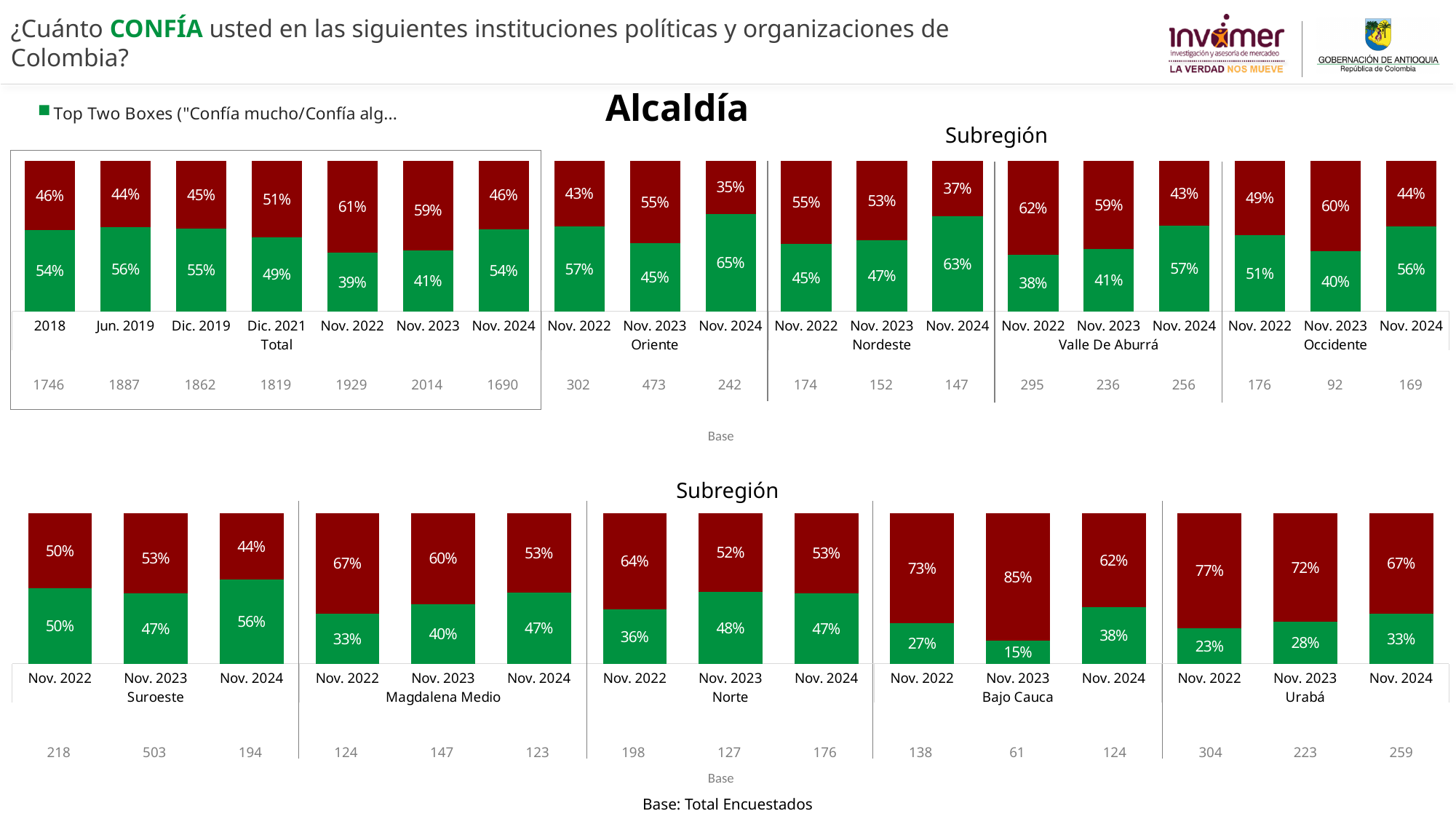
In the top chart, by how many percentage points did the green (Top Two Boxes) value for Total change from Nov. 2023 to Nov. 2024? 13 percentage points In the top chart, what is the base (number of respondents) for Total in Nov. 2024? 1690 In the bottom chart, which bar has the lowest green (Top Two Boxes) value? Bajo Cauca Nov. 2023 In the top chart, how many bars are shown in the Total group? 7 In the top chart, which subregion bar has the highest green (Top Two Boxes) value? Oriente Nov. 2024 In the bottom chart, what is the green (Top Two Boxes) value for Bajo Cauca in Nov. 2023? 15% In the top chart, what is the green (Top Two Boxes) value for Total in Nov. 2022? 39% In the bottom chart, do the green (Top Two Boxes) values for Urabá rise or fall from Nov. 2022 to Nov. 2024? Rise In the top chart, what is the green (Top Two Boxes) value for Total in Nov. 2024? 54% What kind of chart is used on this slide? Stacked bar chart In the bottom chart, which has the larger green (Top Two Boxes) value in Nov. 2024: Norte or Urabá? Norte What is the title of the chart on this slide? Alcaldía